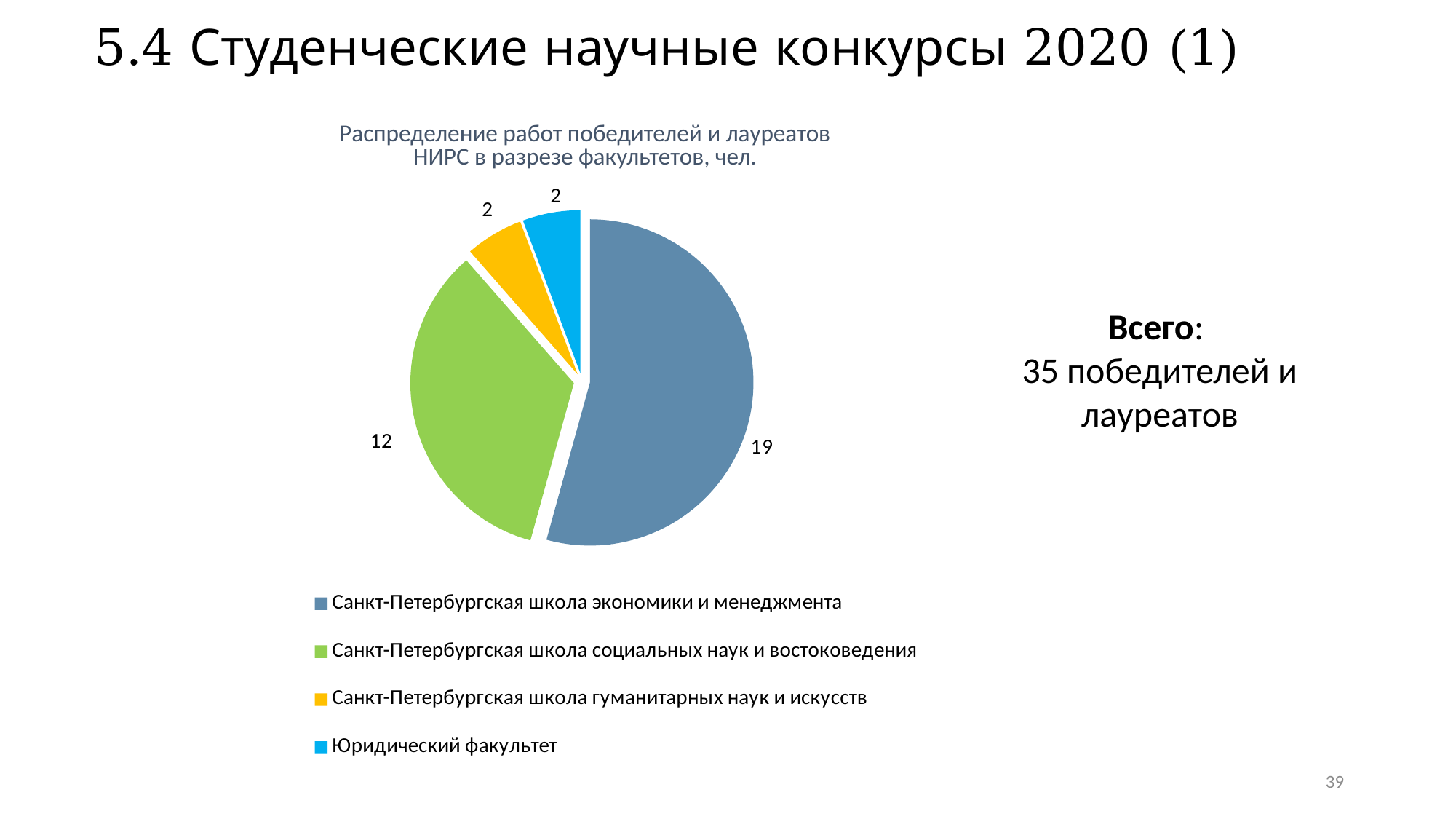
What colour is the slice for Юридический факультет? Light blue What is the value for Юридический факультет? 2 What is the value for Санкт-Петербургская школа социальных наук и востоковедения? 12 What type of chart is shown on the slide? Pie chart Which is larger: the value for Санкт-Петербургская школа социальных наук и востоковедения or for Санкт-Петербургская школа гуманитарных наук и искусств? Санкт-Петербургская школа социальных наук и востоковедения What is the value for Санкт-Петербургская школа гуманитарных наук и искусств? 2 Which faculty has the largest slice of the pie? Санкт-Петербургская школа экономики и менеджмента What is the value for Санкт-Петербургская школа экономики и менеджмента? 19 What is the difference between the values for Санкт-Петербургская школа социальных наук и востоковедения and Юридический факультет? 10 What is the total of all slices in the pie chart? 35 What is the difference between the values for Санкт-Петербургская школа экономики и менеджмента and Санкт-Петербургская школа социальных наук и востоковедения? 7 How many slices does the pie chart have? 4